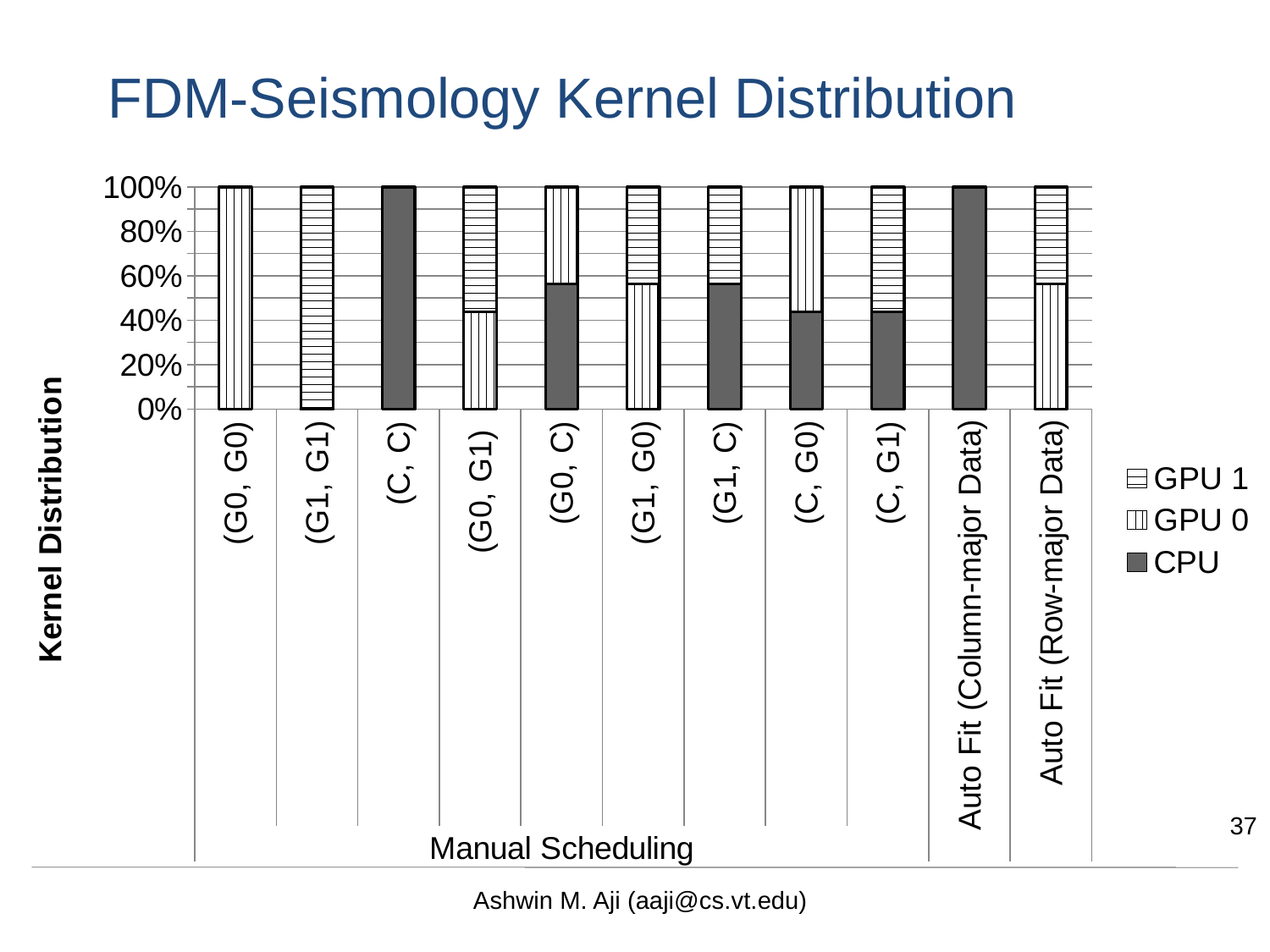
What is the title of the y axis? Kernel Distribution How many categories are shown along the x axis? 11 How many series does the legend list? 3 What is the CPU value for the (C, C) category? 100% What kind of chart is shown on the slide? bar chart What is the CPU value for the Auto Fit (Column-major Data) category? 100% Which series does the solid dark grey fill represent in the legend? CPU What is the GPU 0 value for the (G0, G0) category? 100% What is the total of the stacked bar for (G0, G1)? 100% Is the CPU value for (C, G0) greater or less than 60%? less Is the CPU value for (G0, C) greater or less than 40%? greater Is the GPU 1 value for (G1, G1) greater or less than 80%? greater